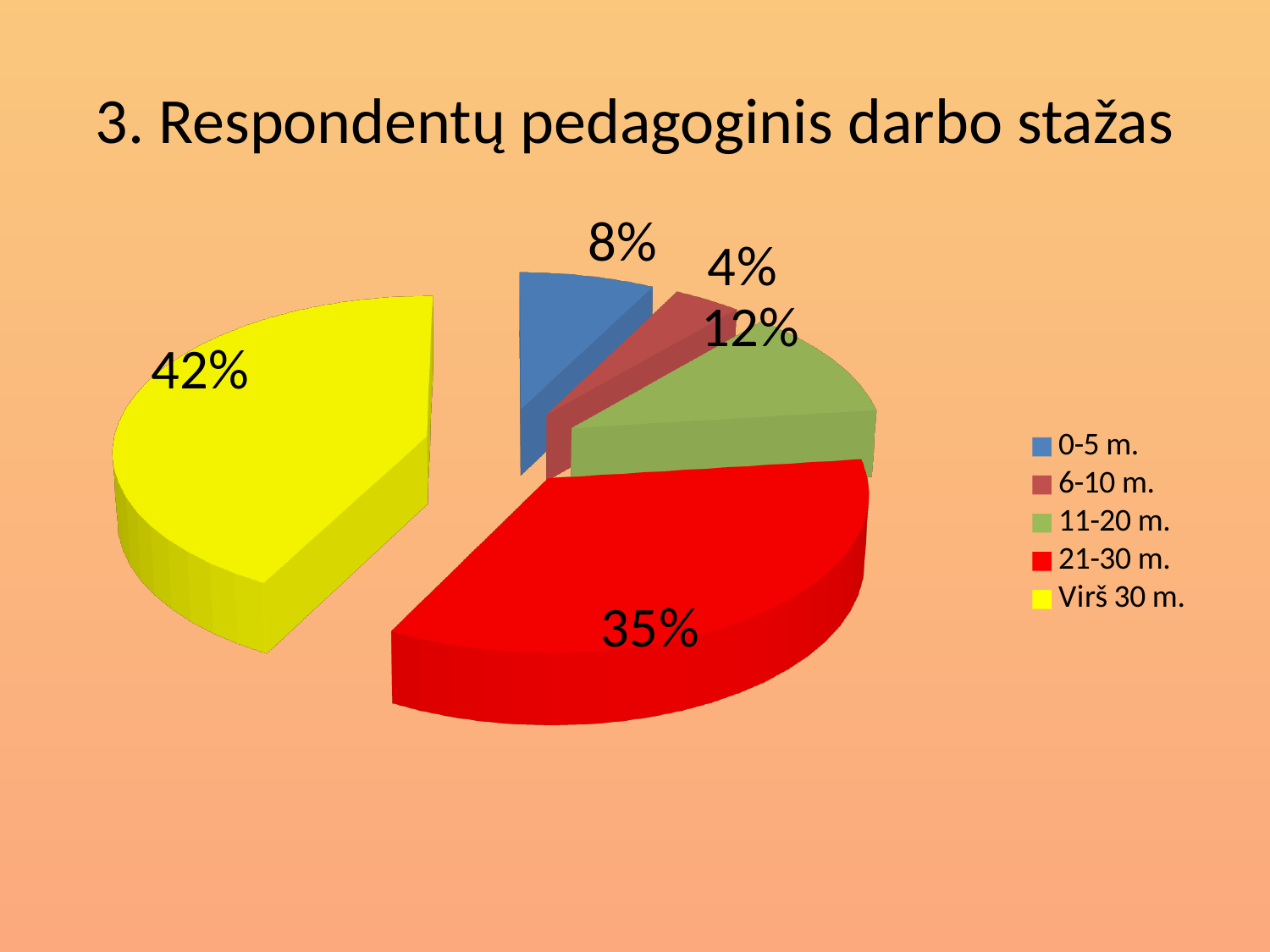
What share of the pie does the 6-10 m. slice represent? 4% What share of the pie does the 21-30 m. slice represent? 35% What is the difference in percentage points between the Virš 30 m. slice and the 21-30 m. slice? 7% What share of the pie does the 0-5 m. slice represent? 8% Which category has the largest slice of the pie? Virš 30 m. What is the title of the chart on the slide? 3. Respondentų pedagoginis darbo stažas Which category has the smallest slice of the pie? 6-10 m. How many categories does the pie chart show? 5 Which is larger, the 0-5 m. slice or the 11-20 m. slice? 11-20 m. What kind of chart is shown on the slide? Pie chart